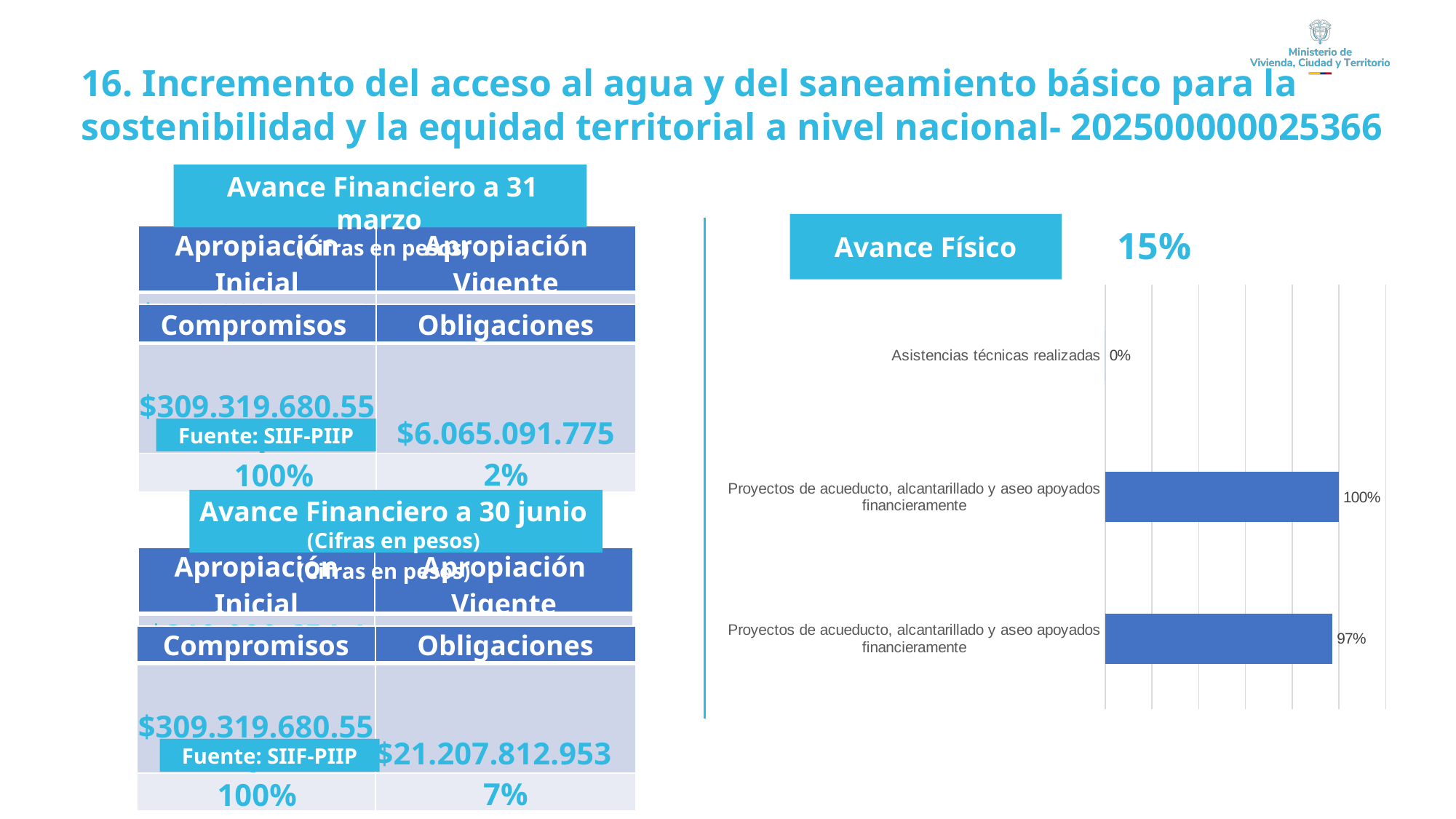
What is the value of the middle bar ("Proyectos de acueducto, alcantarillado y aseo apoyados financieramente") in the bar chart? 100% What percentage is shown next to the "Avance Físico" heading above the bar chart? 15% What is the value of the bottom bar in the bar chart? 97% What is the difference between the middle bar (100%) and the bottom bar (97%) in the bar chart? 3% What kind of chart is shown on the right side of the slide? bar chart What is the difference between the middle bar (100%) and "Asistencias técnicas realizadas" (0%) in the bar chart? 100% Which category has the lowest value in the bar chart? Asistencias técnicas realizadas In the bar chart, is the middle bar or the bottom bar larger? the middle bar What is the value for "Asistencias técnicas realizadas" in the bar chart? 0% How many categories does the bar chart on the right show? 3 What is the highest value shown in the bar chart? 100% What colour are the bars in the bar chart? blue